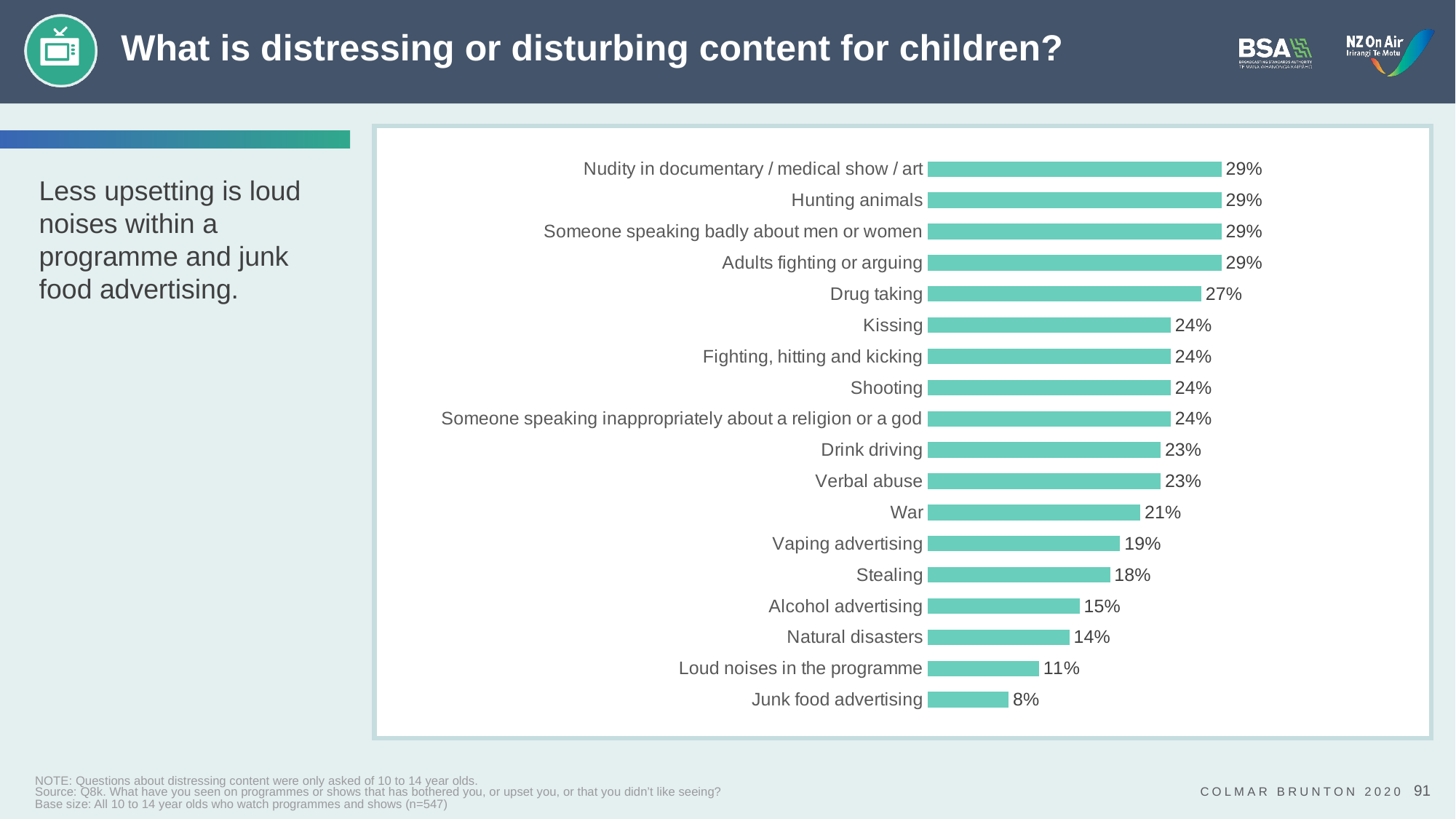
What percentage of children said drug taking is distressing or disturbing content? 27% Which has a higher value, Kissing or Natural disasters? Kissing Which has a higher value, Drink driving or Stealing? Drink driving What type of chart is shown on the slide? Bar chart What is the value shown for Loud noises in the programme? 11% What is the difference between the values for Hunting animals and Junk food advertising? 21 percentage points What is the value shown for War? 21% What is the difference between the values for Stealing and Alcohol advertising? 3 percentage points Which category has the lowest value on the chart? Junk food advertising What is the value shown for Vaping advertising? 19% What is the highest value shown on the chart? 29% How many categories are shown on the chart? 18